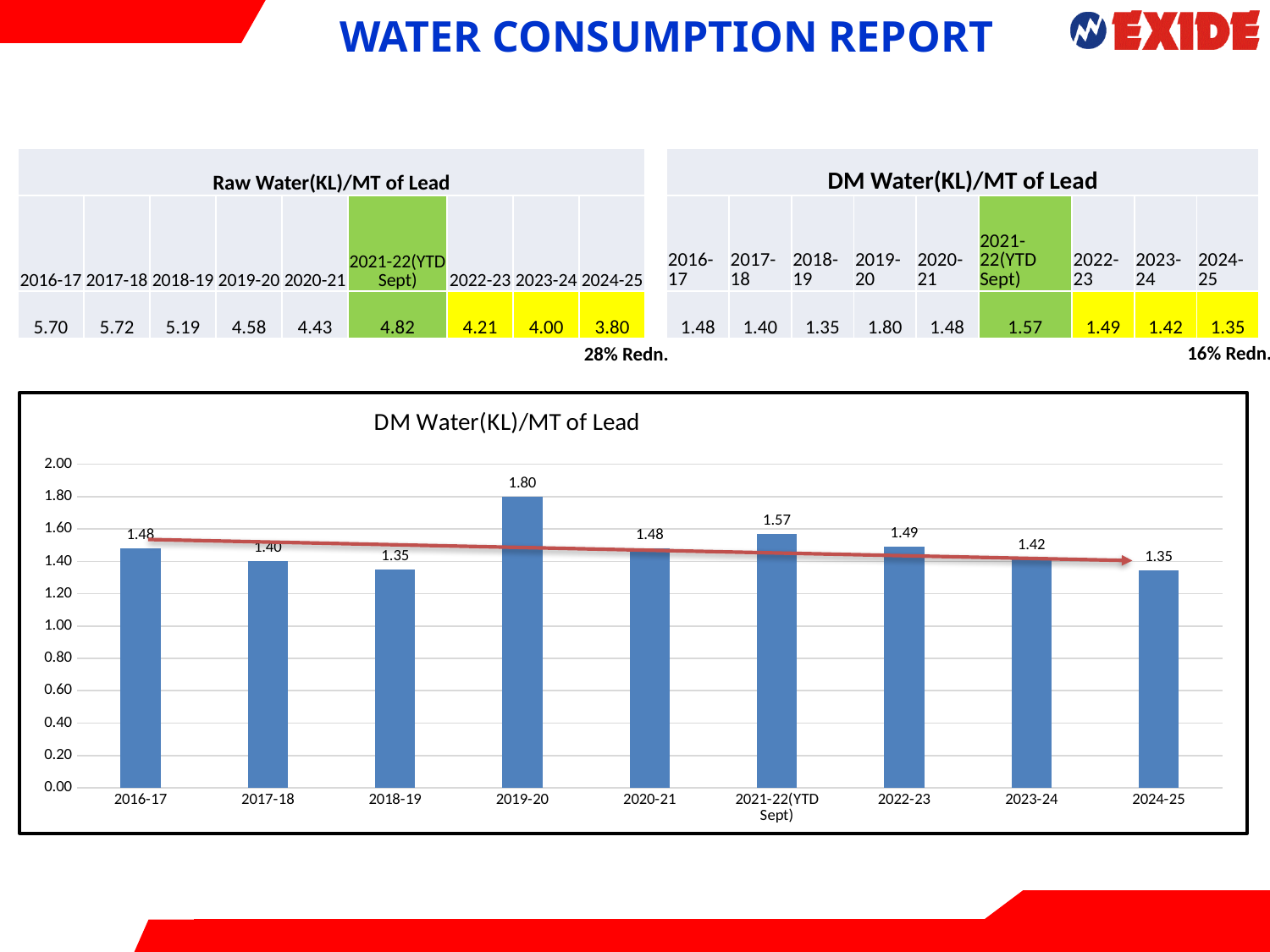
How many years are plotted in the DM Water(KL)/MT of Lead chart? 9 In the DM Water(KL)/MT of Lead chart, which is larger: the value for 2016-17 or the value for 2018-19? 2016-17 What is the title of the chart on the slide? DM Water(KL)/MT of Lead What is the difference between the 2021-22(YTD Sept) and 2022-23 values in the DM Water(KL)/MT of Lead chart? 0.08 What is the value for 2019-20 in the DM Water(KL)/MT of Lead chart? 1.80 What is the difference between the 2019-20 and 2024-25 values in the DM Water(KL)/MT of Lead chart? 0.45 Which year has the highest value in the DM Water(KL)/MT of Lead chart? 2019-20 What type of chart is the DM Water(KL)/MT of Lead chart? bar chart What is the value for 2021-22(YTD Sept) in the DM Water(KL)/MT of Lead chart? 1.57 What is the value for 2024-25 in the DM Water(KL)/MT of Lead chart? 1.35 What is the value for 2017-18 in the DM Water(KL)/MT of Lead chart? 1.40 In the DM Water(KL)/MT of Lead chart, is the value for 2019-20 greater or less than 1.60? greater